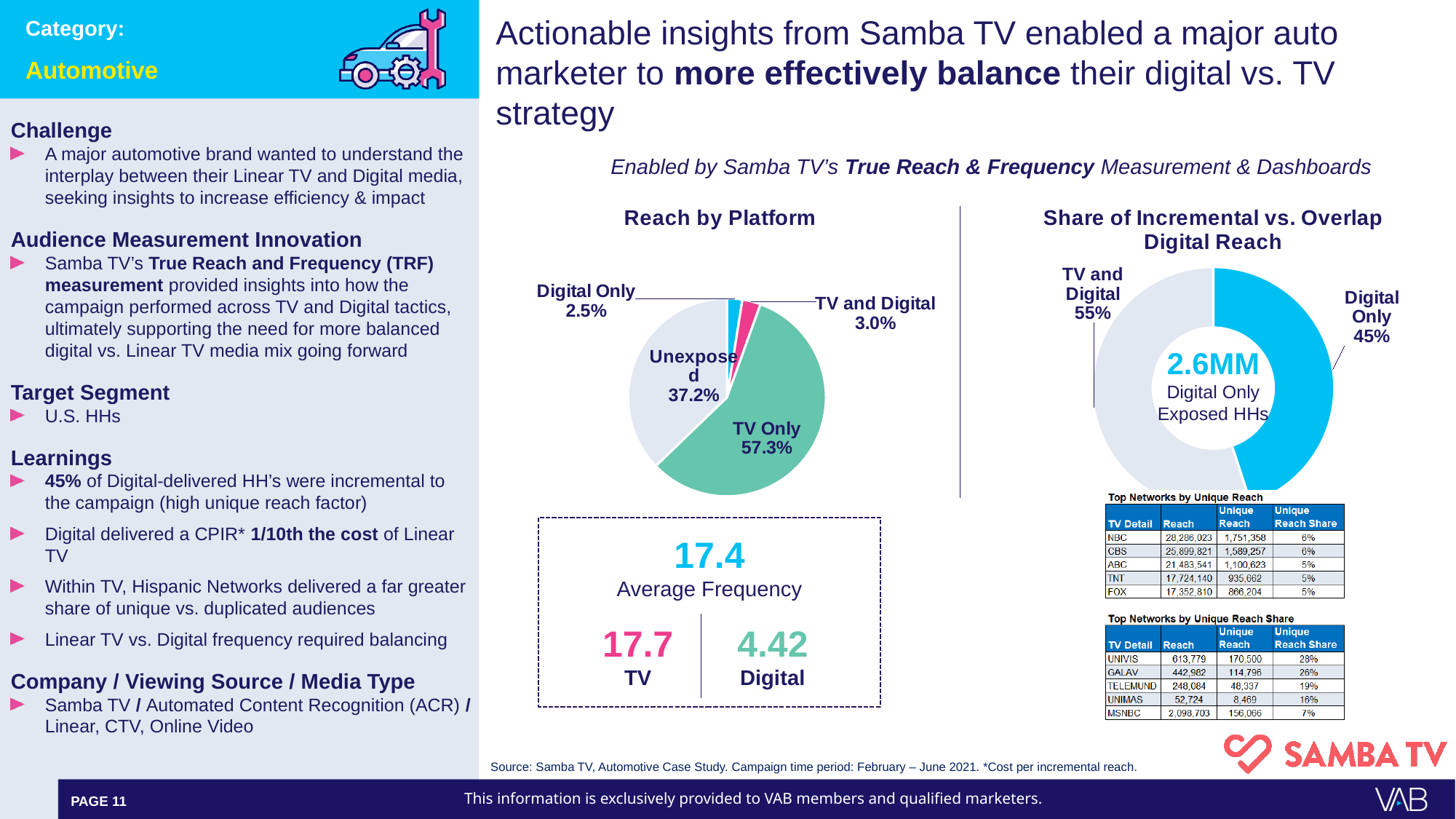
In the Share of Incremental vs. Overlap Digital Reach chart, what share is TV and Digital? 55% In the Reach by Platform chart, which is larger, TV and Digital or Digital Only? TV and Digital What kind of chart is the Reach by Platform chart? Pie chart In the Reach by Platform chart, what share is Unexposed? 37.2% In the Reach by Platform chart, which category has the largest share? TV Only In the Reach by Platform chart, what share is TV Only? 57.3% In the Share of Incremental vs. Overlap Digital Reach chart, what share is Digital Only? 45% In the Reach by Platform chart, which category has the smallest share? Digital Only What value is shown in the center of the Share of Incremental vs. Overlap Digital Reach donut chart? 2.6MM In the Reach by Platform chart, what is the difference between the TV Only and Unexposed shares? 20.1 percentage points In the Reach by Platform chart, what share is Digital Only? 2.5% In the Reach by Platform chart, how many slices does the pie have? 4